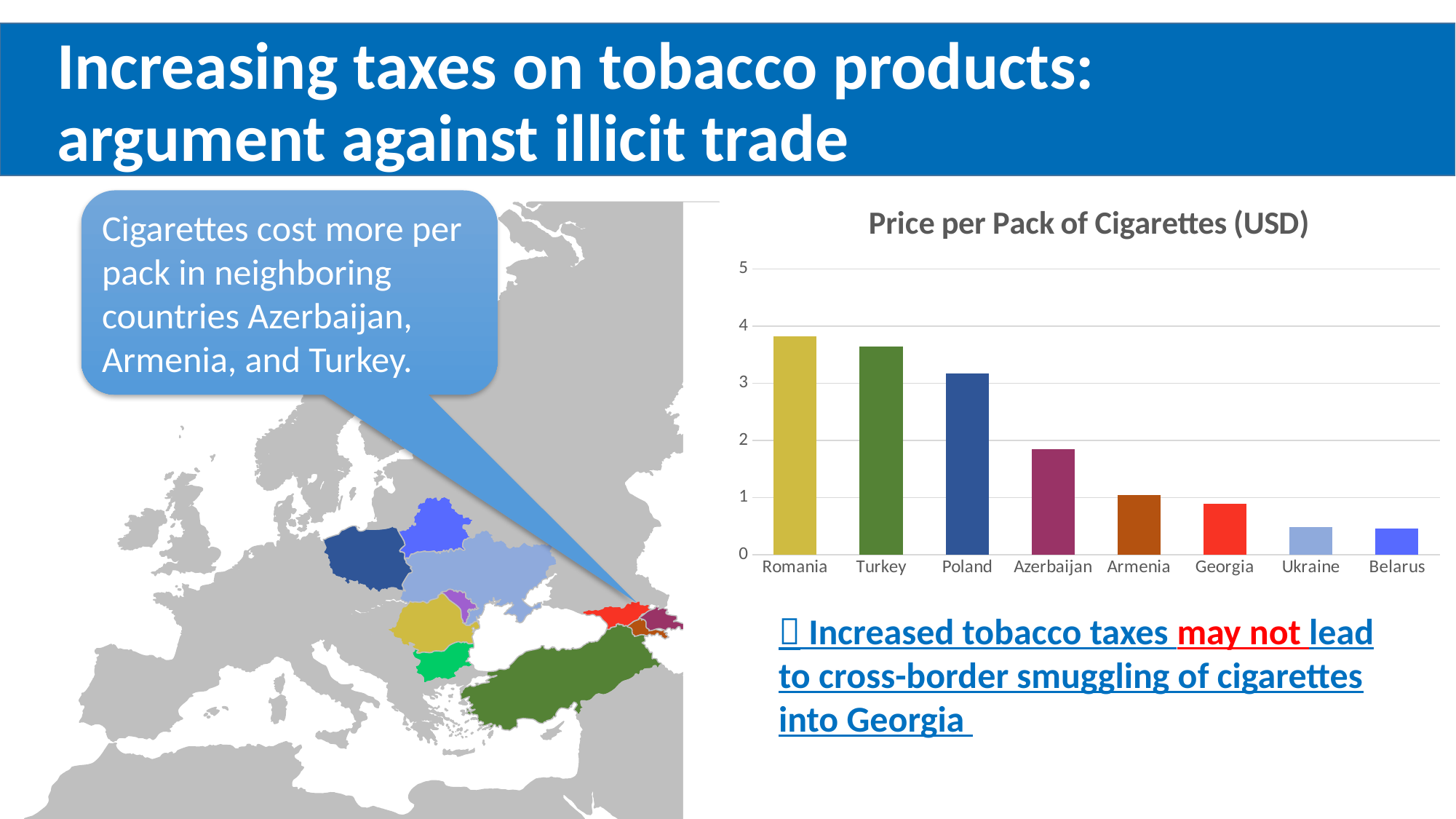
Which country has the highest price per pack of cigarettes in the chart? Romania Is the value for Poland greater or less than 3? greater Is the value for Azerbaijan greater or less than 2? less Is the value for Georgia greater or less than 1? less What is the title of the chart? Price per Pack of Cigarettes (USD) What kind of chart is shown on the slide? bar chart Which has a higher price per pack, Georgia or Azerbaijan? Azerbaijan Which has a higher price per pack, Poland or Azerbaijan? Poland How many countries are shown on the x axis of the chart? 8 Do the values rise or fall moving from left to right along the x axis? fall